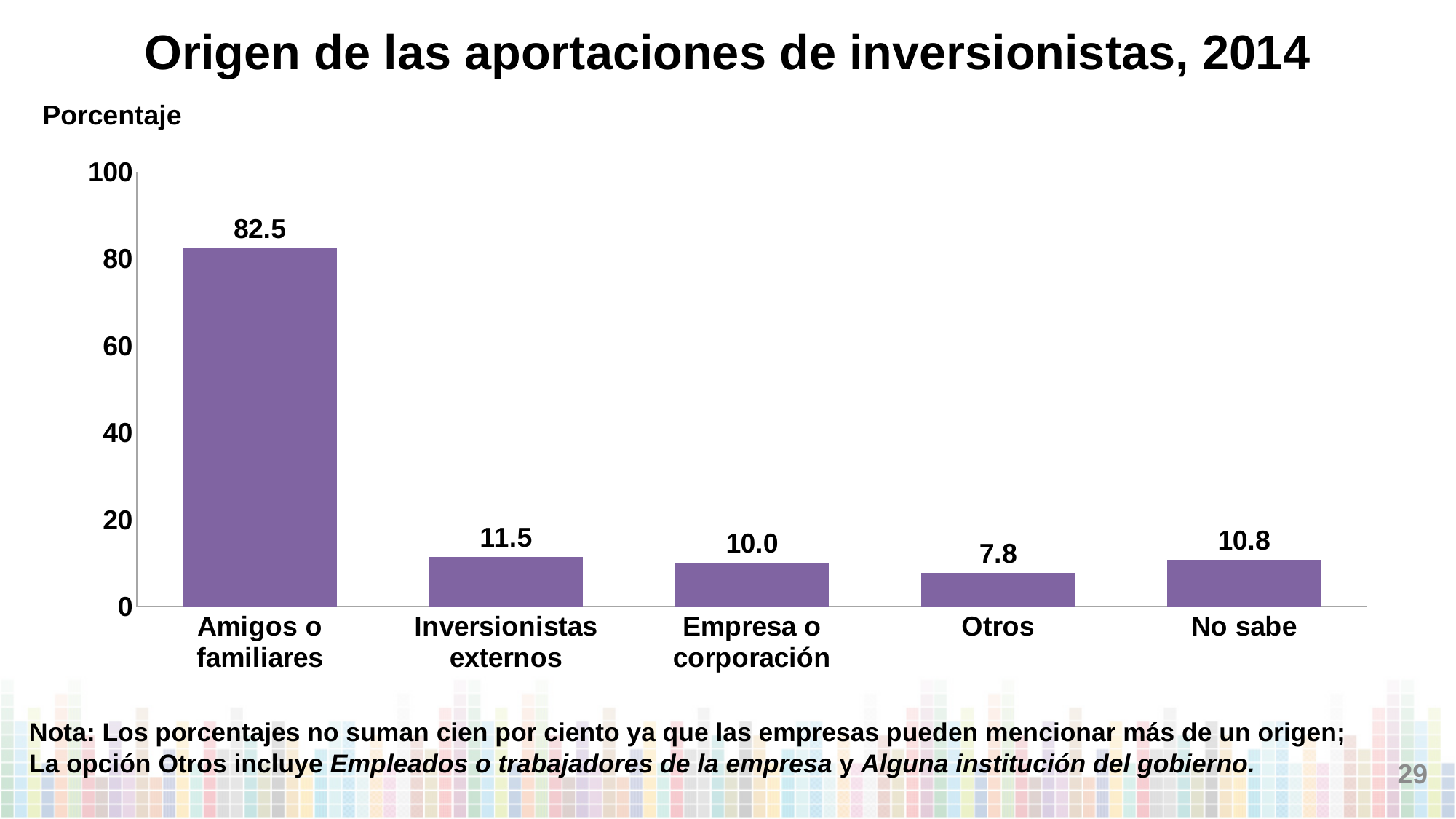
Is the value for Amigos o familiares greater or less than 80? greater What is the value for Otros? 7.8 Which category has the lowest value? Otros Which is larger, the value for No sabe or the value for Empresa o corporación? No sabe What is the value for Empresa o corporación? 10.0 What is the difference between the values for Amigos o familiares and Inversionistas externos? 71.0 How many categories are shown in the chart? 5 What is the value for No sabe? 10.8 What is the value for Inversionistas externos? 11.5 What kind of chart is shown on the slide? Bar chart What is the value for Amigos o familiares? 82.5 Which category has the highest value? Amigos o familiares